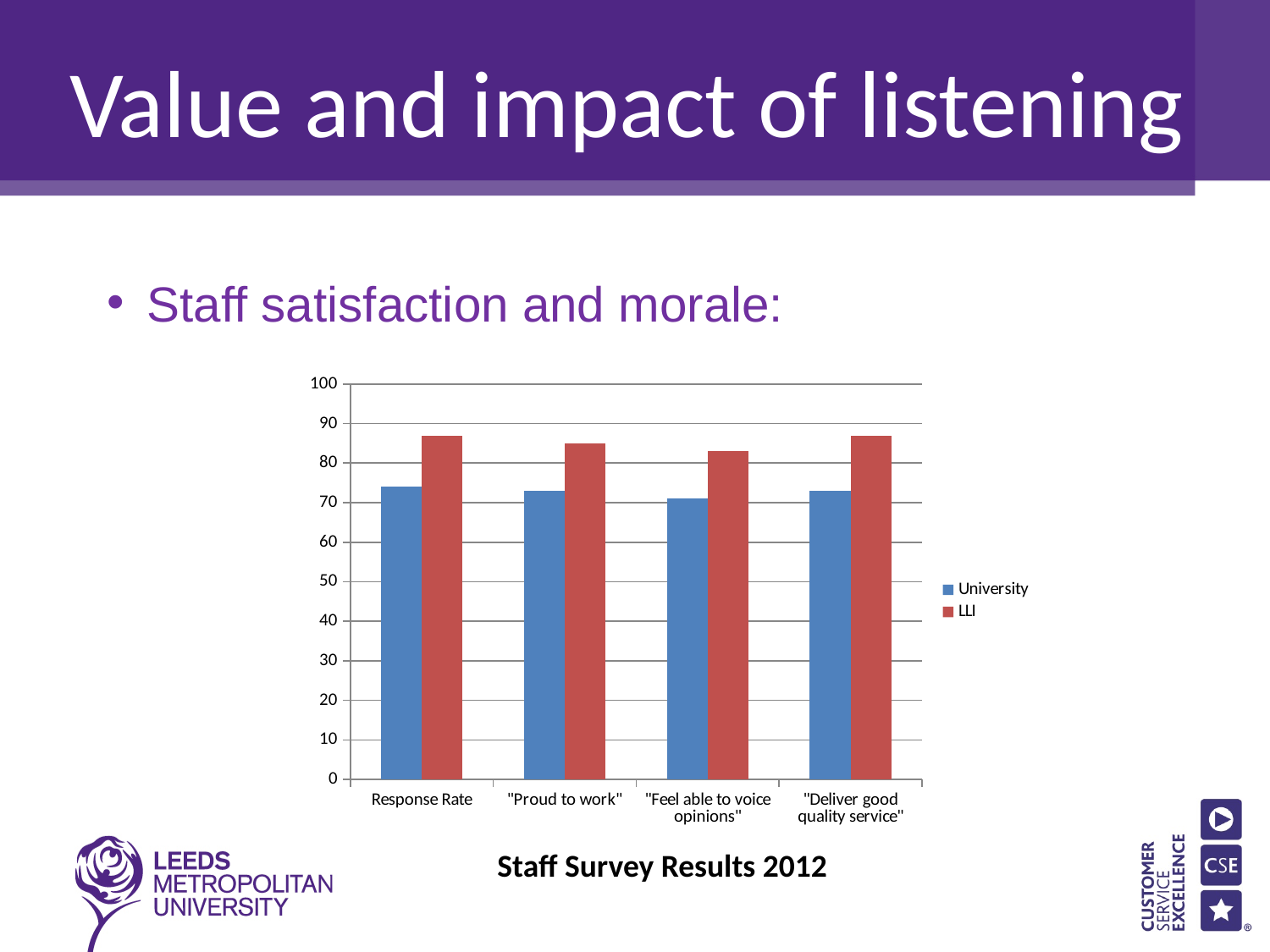
What is the title shown beneath the chart? Staff Survey Results 2012 What are the two series named in the chart's legend? University and LLI Is the University value for "Feel able to voice opinions" greater or less than 80? less How many series does the chart's legend list? 2 How many categories are shown on the x axis of the chart? 4 Is the LLI value for "Deliver good quality service" greater or less than 90? less Is the LLI value for "Response Rate" greater or less than 80? greater For "Proud to work", which series has the larger value, University or LLI? LLI For "Feel able to voice opinions", which series has the larger value, University or LLI? LLI For "Response Rate", which series has the larger value, University or LLI? LLI What kind of chart is shown on the slide? bar chart